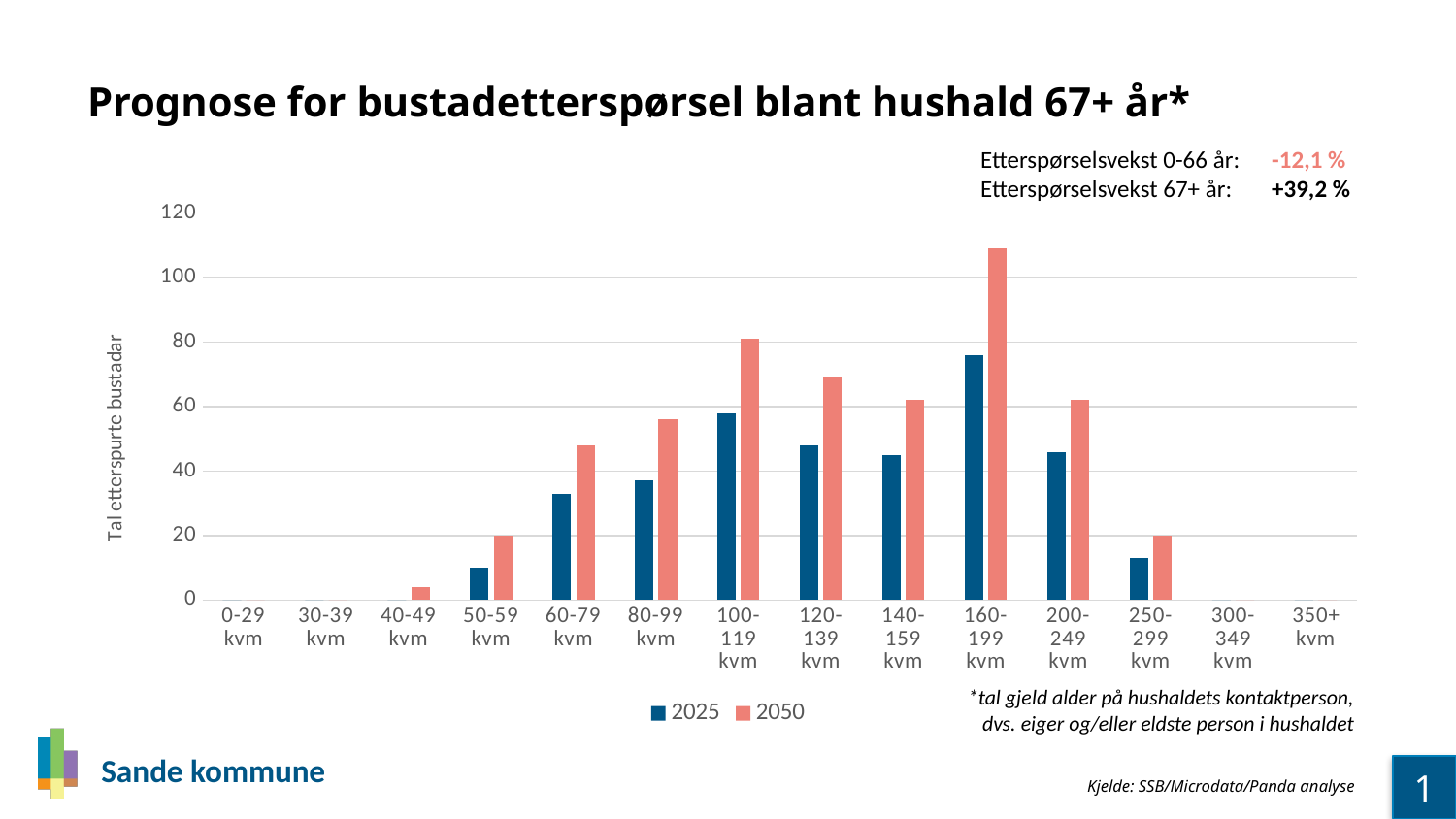
Is the 2050 value for 160-199 kvm greater or less than 100? greater For 100-119 kvm, which series has the larger value, 2025 or 2050? 2050 Is the 2025 value for 60-79 kvm greater or less than 40? less How many series does the legend list? 2 Which size category has the highest value for the 2050 series? 160-199 kvm Which size category has the highest value for the 2025 series? 160-199 kvm What is the title of the chart? Prognose for bustadetterspørsel blant hushald 67+ år* Is the 2025 value for 250-299 kvm greater or less than 20? less What are the two entries in the chart legend? 2025 and 2050 What kind of chart is shown on the slide? bar chart How many size categories are shown on the x axis? 14